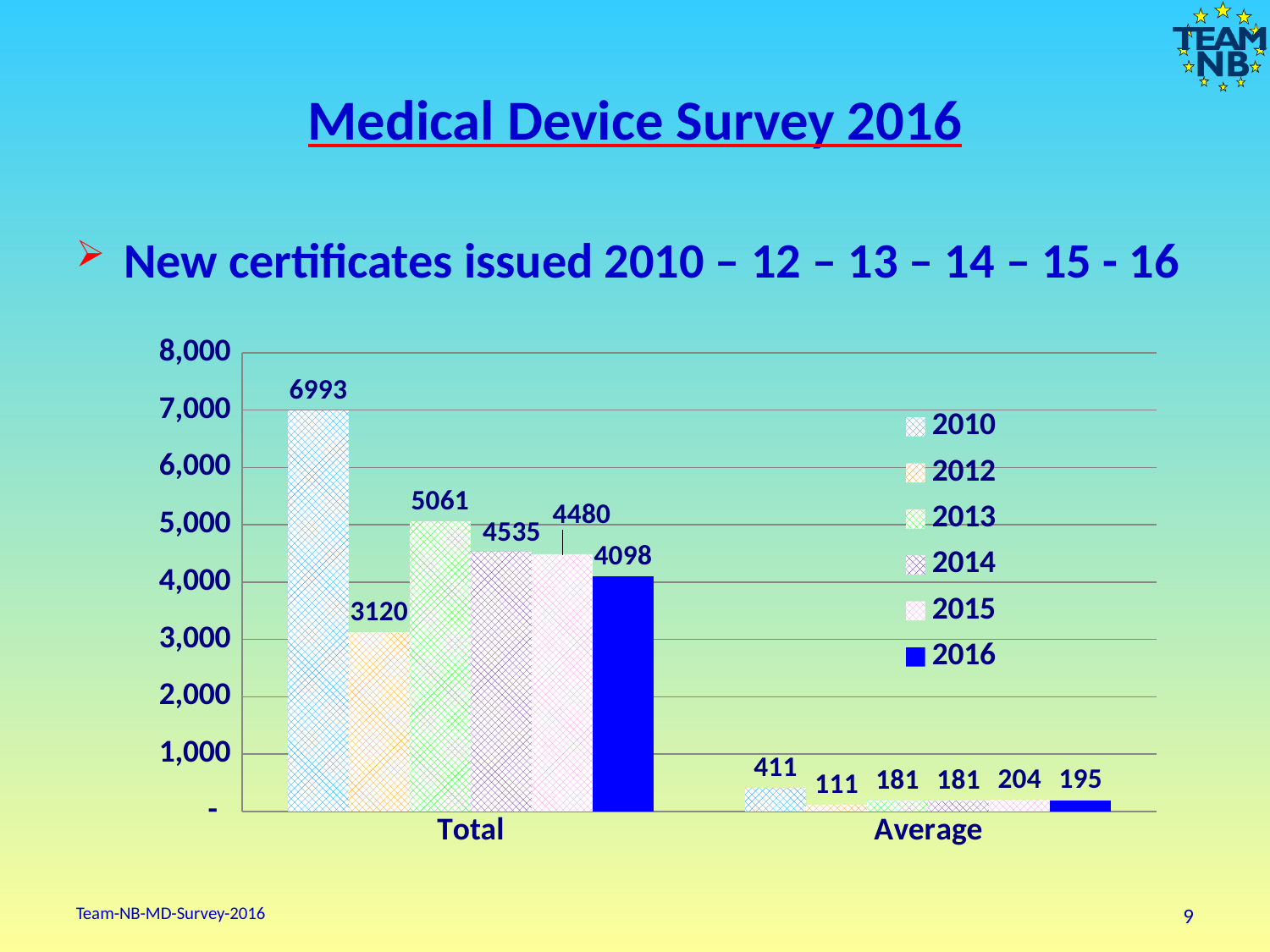
Is the Total value for 2016 greater or less than 4,000? greater What is the difference between the Total values for 2010 and 2012? 3873 Which year has the lowest Average value? 2012 Which series is drawn as a solid blue bar? 2016 What is the Total value for 2010? 6993 What kind of chart is shown on the slide? bar chart Which is larger, the Total value for 2014 or the Total value for 2015? 2014 How many series does the legend list? 6 What is the difference between the Average values for 2015 and 2016? 9 What is the Total value for 2013? 5061 What is the Average value for 2016? 195 Which year has the highest Total value? 2010